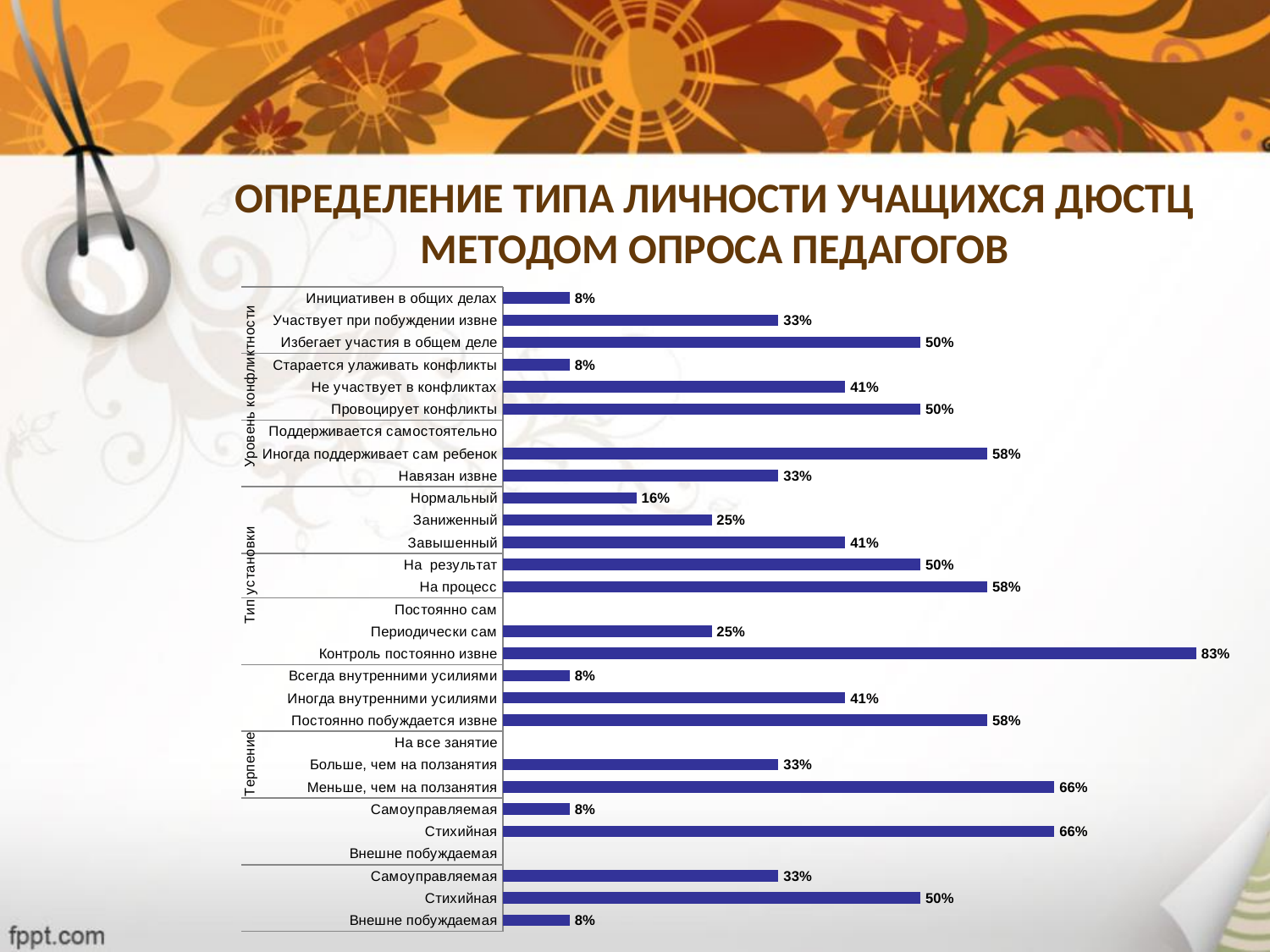
Which is larger: the value for "Завышенный" or for "Заниженный"? Завышенный What is the value for "Нормальный"? 16% What is the difference between the values for "На процесс" and "На результат"? 8% What is the value for "Избегает участия в общем деле"? 50% What is the value for "Меньше, чем на ползанятия"? 66% What is the difference between the values for "Контроль постоянно извне" and "Периодически сам"? 58% What is the value for "Иногда поддерживает сам ребенок"? 58% Which is larger: the value for "Избегает участия в общем деле" or for "Участвует при побуждении извне"? Избегает участия в общем деле What kind of chart is shown on the slide? bar chart What is the title of the chart on the slide? ОПРЕДЕЛЕНИЕ ТИПА ЛИЧНОСТИ УЧАЩИХСЯ ДЮСТЦ МЕТОДОМ ОПРОСА ПЕДАГОГОВ What is the value for "Контроль постоянно извне"? 83% Which category has the highest value in the chart? Контроль постоянно извне